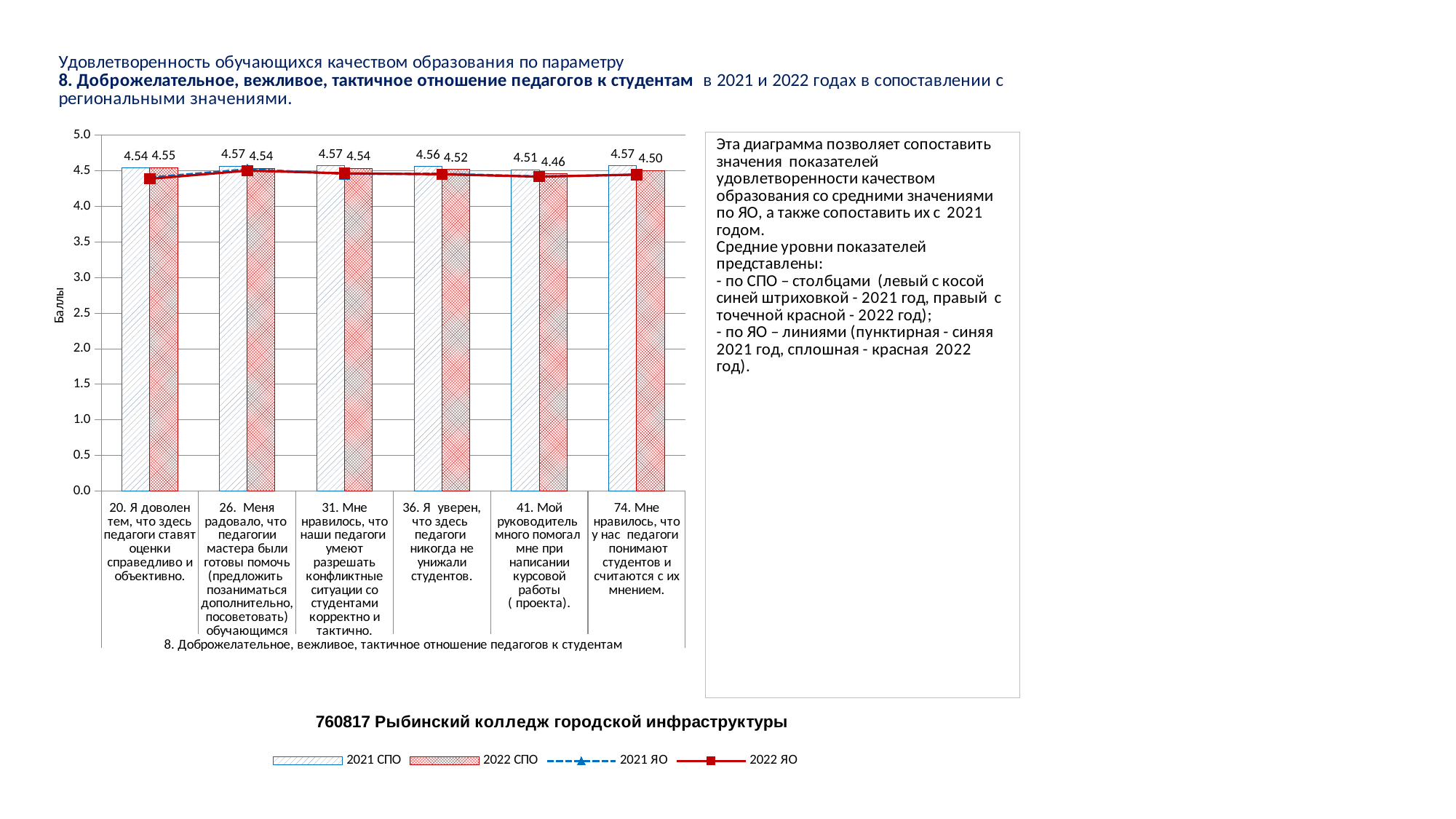
What is the 2021 СПО value for item 20 (Я доволен тем, что здесь педагоги ставят оценки справедливо и объективно)? 4.54 What kind of chart is used to show the СПО series? bar chart What is the 2022 СПО value for item 74 (Мне нравилось, что у нас педагоги понимают студентов и считаются с их мнением)? 4.50 How many series does the legend list? 4 Which item has the lowest 2021 СПО value? 41. Мой руководитель много помогал мне при написании курсовой работы (проекта). What is the label of the vertical axis? Баллы Is the 2022 ЯО value for item 41 greater or less than 4.0? greater How many items (categories) are shown on the x axis? 6 Which item has the highest 2022 СПО value? 20. Я доволен тем, что здесь педагоги ставят оценки справедливо и объективно. What is the difference between the 2021 СПО and 2022 СПО values for item 74? 0.07 For item 20, which is larger: the 2021 СПО value or the 2022 СПО value? 2022 СПО What is the 2022 СПО value for item 41 (Мой руководитель много помогал мне при написании курсовой работы)? 4.46